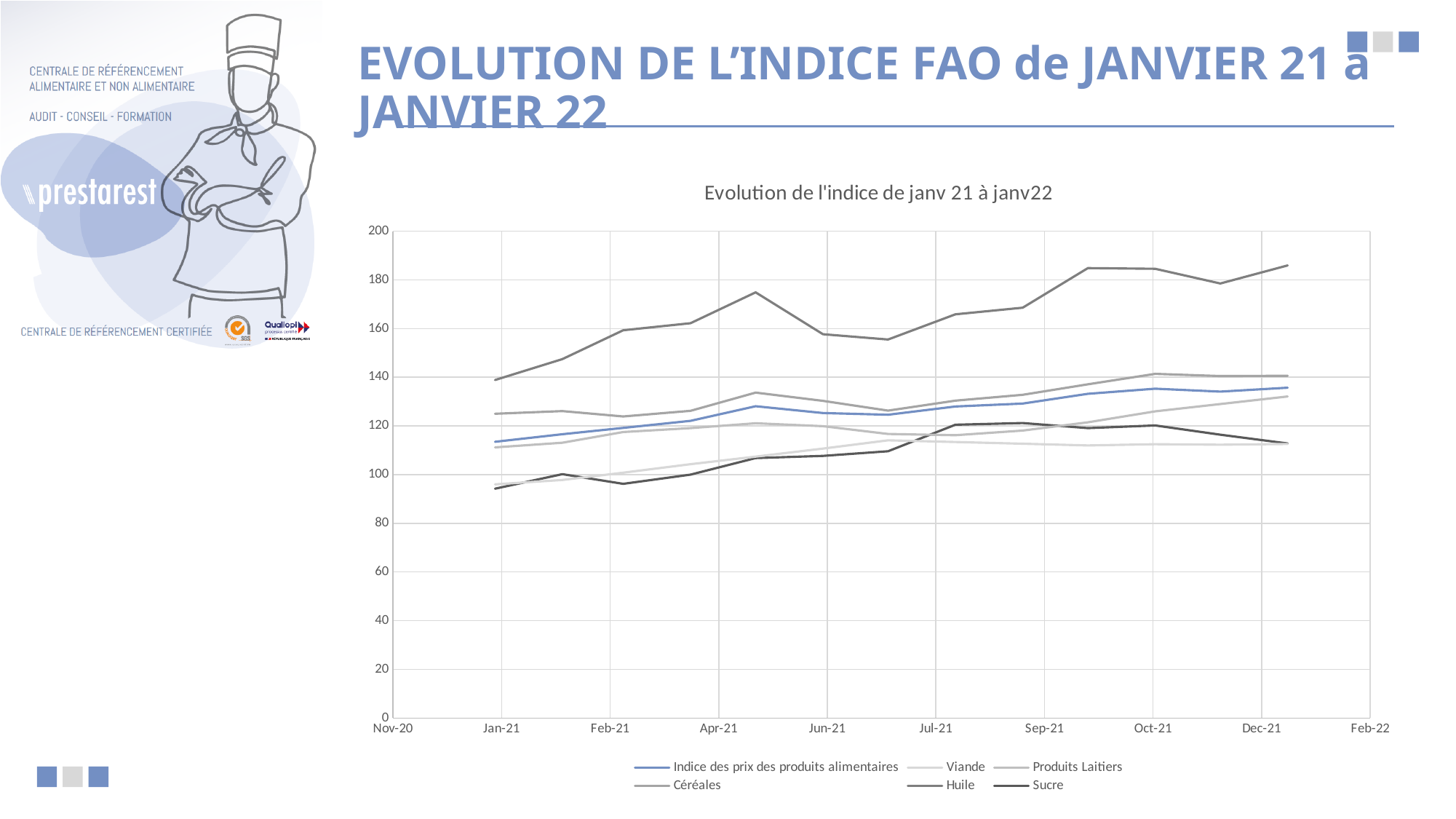
Is the value for Sucre at Jan-21 greater or less than 100? less What is the title of the chart? Evolution de l'indice de janv 21 à janv22 Is the value for Viande at Jan-21 greater or less than 100? less What kind of chart is shown on the slide? line chart Is the value for Indice des prix des produits alimentaires at Dec-21 greater or less than 120? greater Which series has the lowest value at Jan-21? Sucre Does the Indice des prix des produits alimentaires series generally rise or fall from Jan-21 to Dec-21? rise At Jul-21, which is larger: Huile or Sucre? Huile How many series does the legend list? 6 Which series has the highest value at Dec-21? Huile At Apr-21, which is larger: Céréales or Viande? Céréales